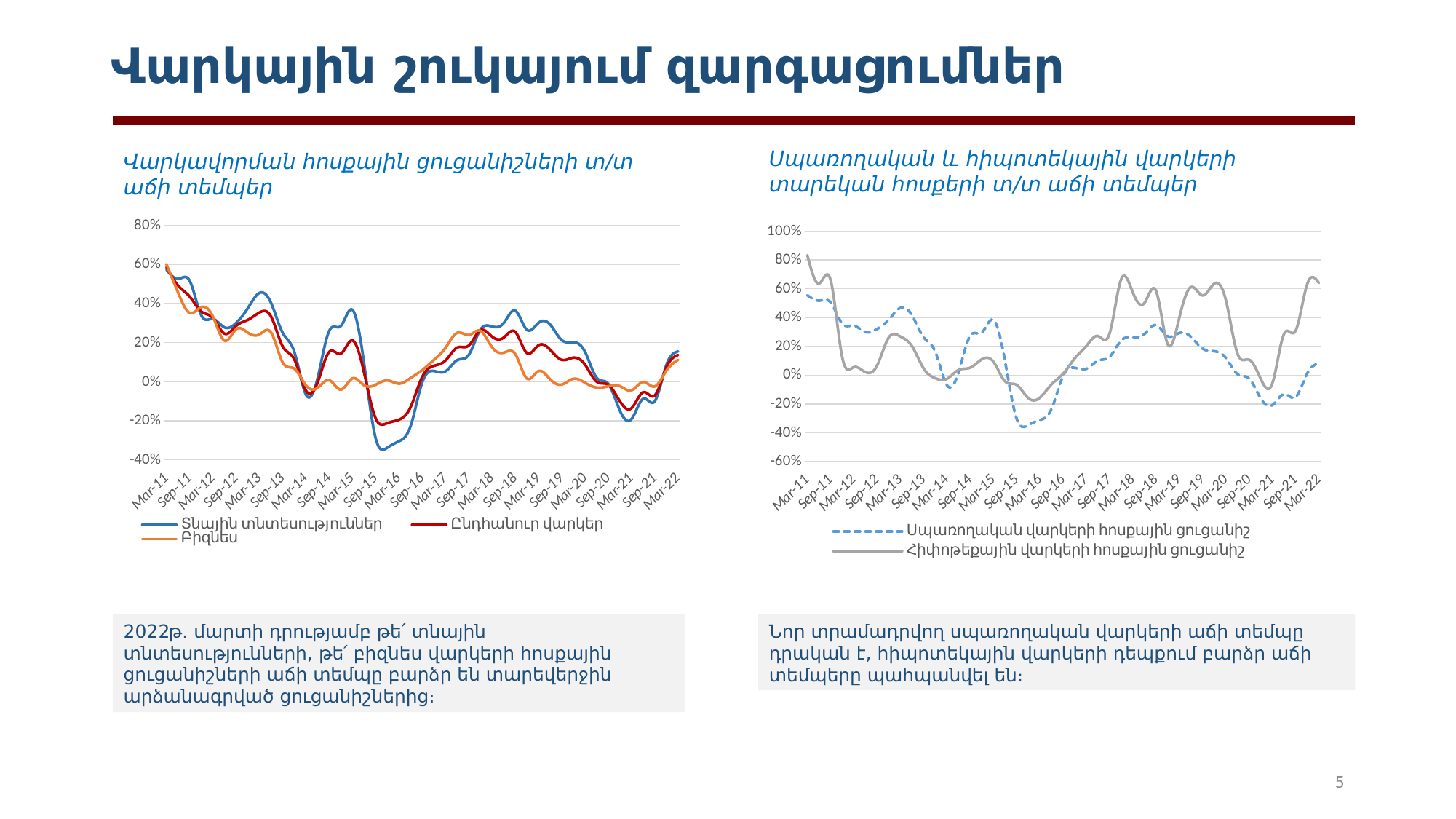
In the right chart, is the value of Սպառողական վարկերի հոսքային ցուցանիշ at Mar-16 greater or less than -20%? less In the left chart, is the value of Տնային տնտեսություններ at Mar-16 greater or less than -20%? less In the right chart, does the Հիպոթեքային վարկերի հոսքային ցուցանիշ line rise or fall from Sep-21 to Mar-22? Rise How many series does the legend of the left chart list? 3 What kind of chart is the left chart titled "Վարկավորման հոսքային ցուցանիշների տ/տ աճի տեմպեր"? Line chart In the right chart, which series is drawn as a dashed blue line? Սպառողական վարկերի հոսքային ցուցանիշ In the left chart, does the Տնային տնտեսություններ line rise or fall from Mar-11 to Mar-14? Fall In the right chart, at Mar-22, which series has the higher value: Սպառողական վարկերի հոսքային ցուցանիշ or Հիպոթեքային վարկերի հոսքային ցուցանիշ? Հիպոթեքային վարկերի հոսքային ցուցանիշ In the left chart, is the value of Տնային տնտեսություններ at Mar-11 greater or less than 40%? greater In the left chart, which series is drawn in red? Ընդհանուր վարկեր How many series does the legend of the right chart list? 2